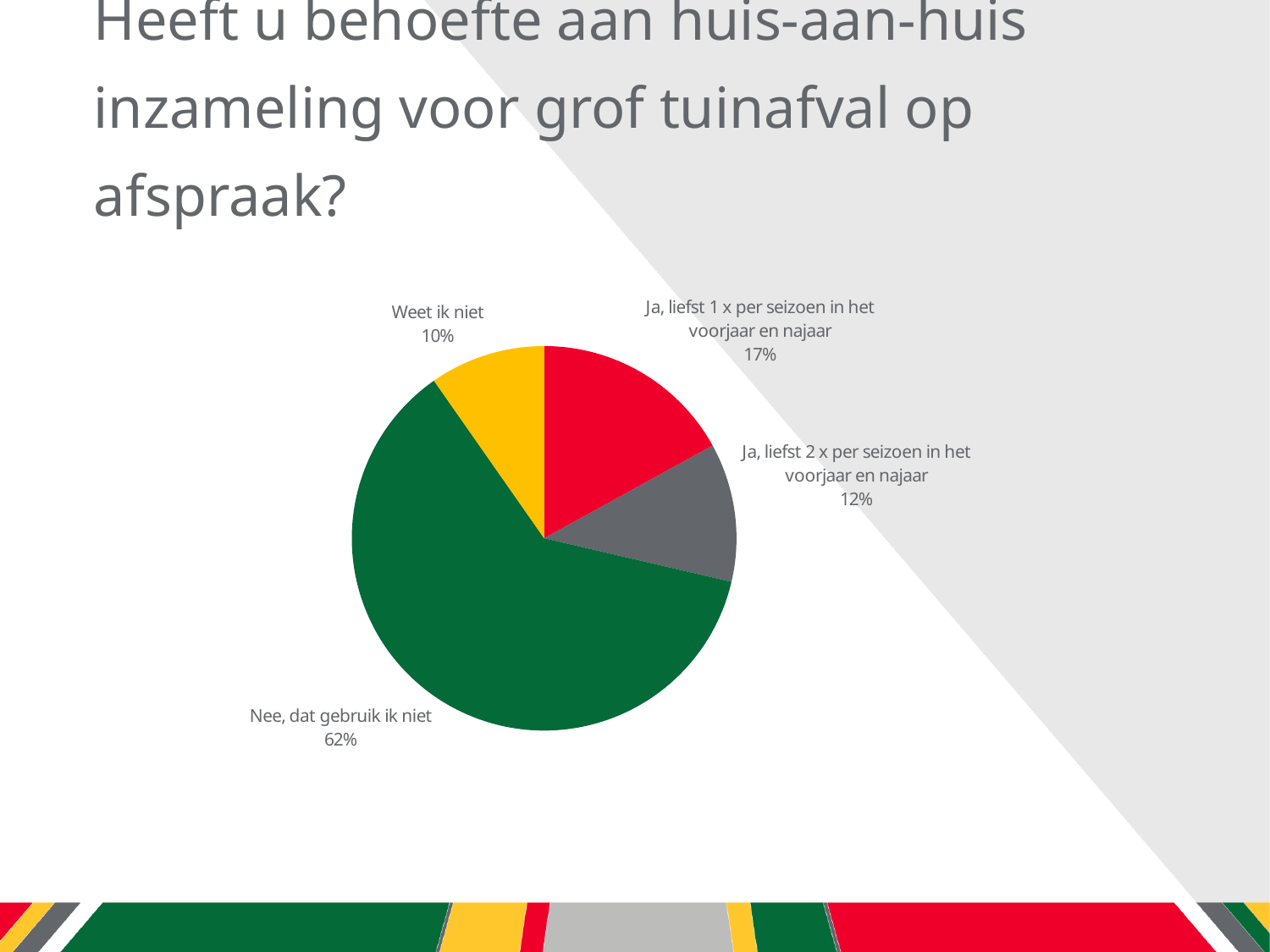
Which answer category has the largest slice of the pie? Nee, dat gebruik ik niet What kind of chart is shown on the slide? pie chart What is the combined share of the two 'Ja' answers? 29% What share of respondents answered 'Ja, liefst 1 x per seizoen in het voorjaar en najaar'? 17% What share of respondents answered 'Weet ik niet'? 10% How many slices does the pie chart have? 4 Which answer category has the smallest slice of the pie? Weet ik niet What is the difference in percentage points between 'Nee, dat gebruik ik niet' and 'Ja, liefst 1 x per seizoen in het voorjaar en najaar'? 45 percentage points What colour is the slice for 'Nee, dat gebruik ik niet'? green What share of respondents answered 'Nee, dat gebruik ik niet'? 62% What share of respondents answered 'Ja, liefst 2 x per seizoen in het voorjaar en najaar'? 12% Which is larger: the share for 'Ja, liefst 1 x per seizoen in het voorjaar en najaar' or for 'Ja, liefst 2 x per seizoen in het voorjaar en najaar'? Ja, liefst 1 x per seizoen in het voorjaar en najaar